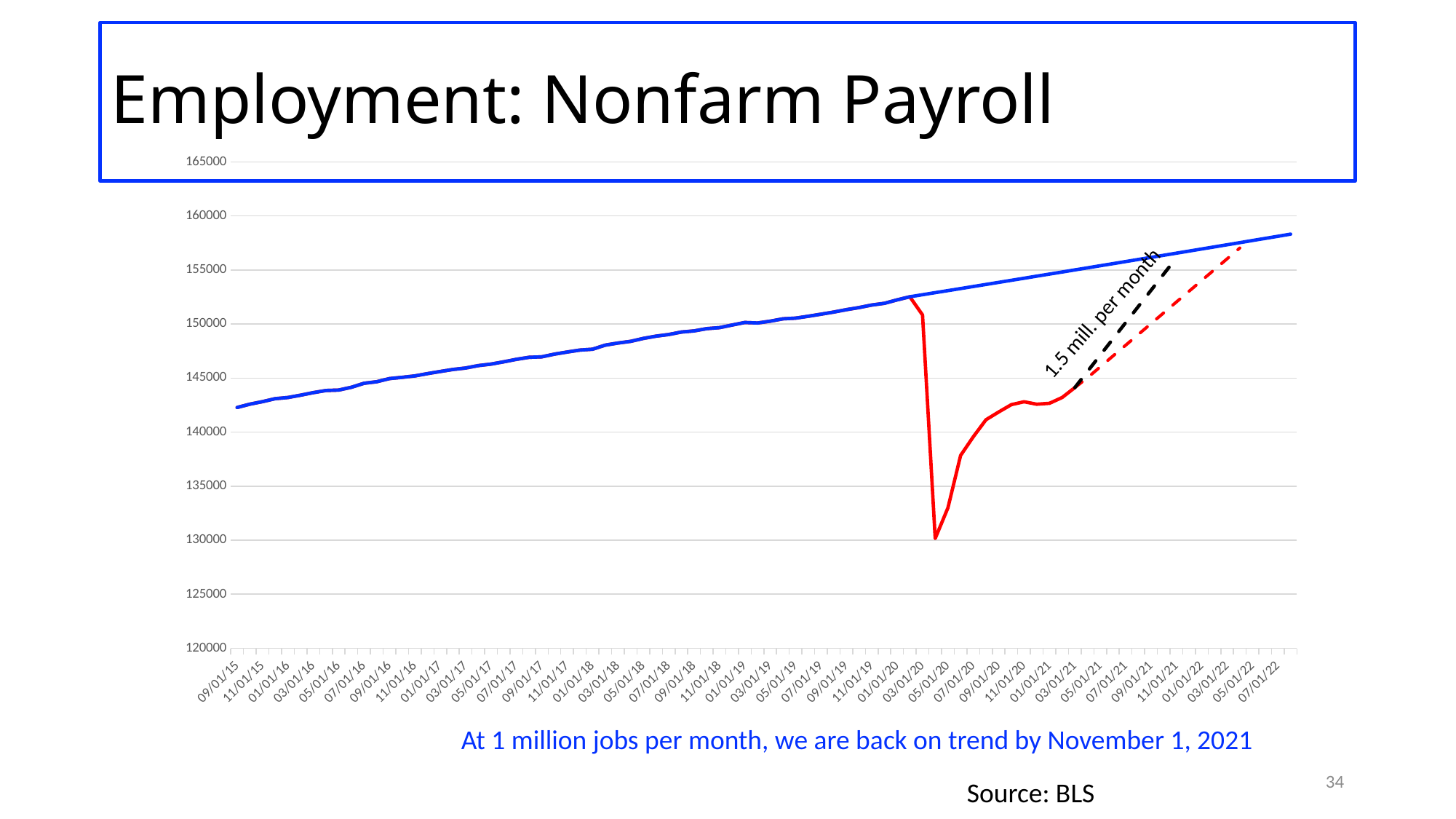
Which is higher: the blue line at 01/01/20 or the blue line at 09/01/15? 01/01/20 Is the value of the blue line at 07/01/22 greater or less than 155000? greater What kind of chart is shown on the slide? line chart Is the value of the blue line at 09/01/15 greater or less than 140000? greater Is the value of the blue line at 09/01/15 greater or less than 145000? less What is the title of the slide containing the chart? Employment: Nonfarm Payroll What rate is written next to the black dashed line on the chart? 1.5 mill. per month Which is higher: the blue line at 07/01/22 or the red line at 01/01/21? the blue line at 07/01/22 Does the blue trend line rise or fall from left to right across the chart? rise